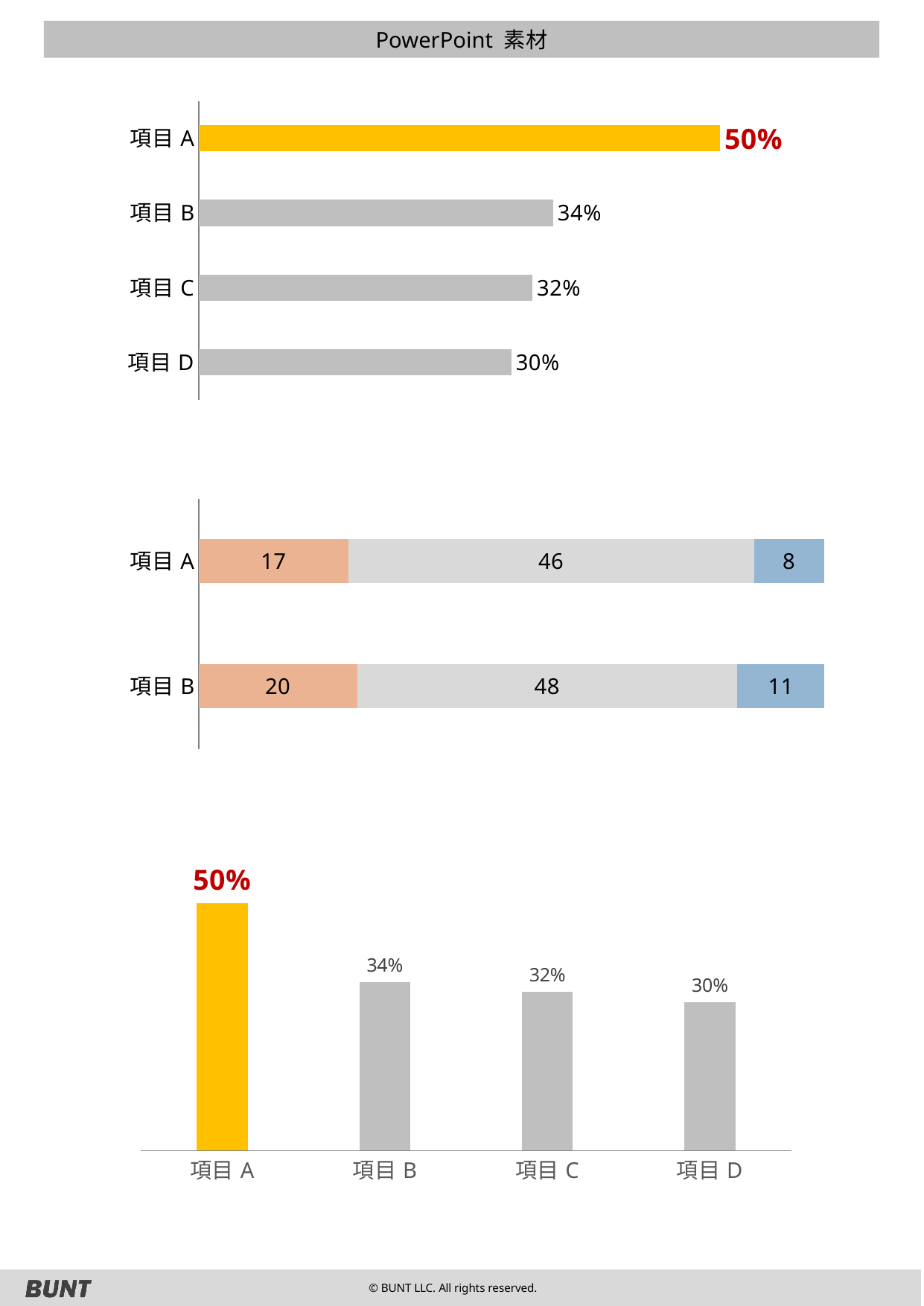
In the top chart, what is the value for 項目 A? 50% In the middle chart, which is larger: the blue segment for 項目 A or the blue segment for 項目 B? 項目 B In the top chart, which category has the lowest value? 項目 D In the bottom chart, do the values rise or fall from 項目 A to 項目 D? Fall In the top chart, what is the difference between 項目 A and 項目 B? 16% In the top chart, how many categories are shown? 4 In the middle chart, what is the value of the middle (grey) segment for 項目 B? 48 In the middle chart, what is the total of the stacked bar for 項目 A? 71 What kind of chart is the top chart? Bar chart In the bottom chart, which category has the highest value? 項目 A In the middle chart, what is the total of the stacked bar for 項目 B? 79 In the bottom chart, what is the value for 項目 C? 32%